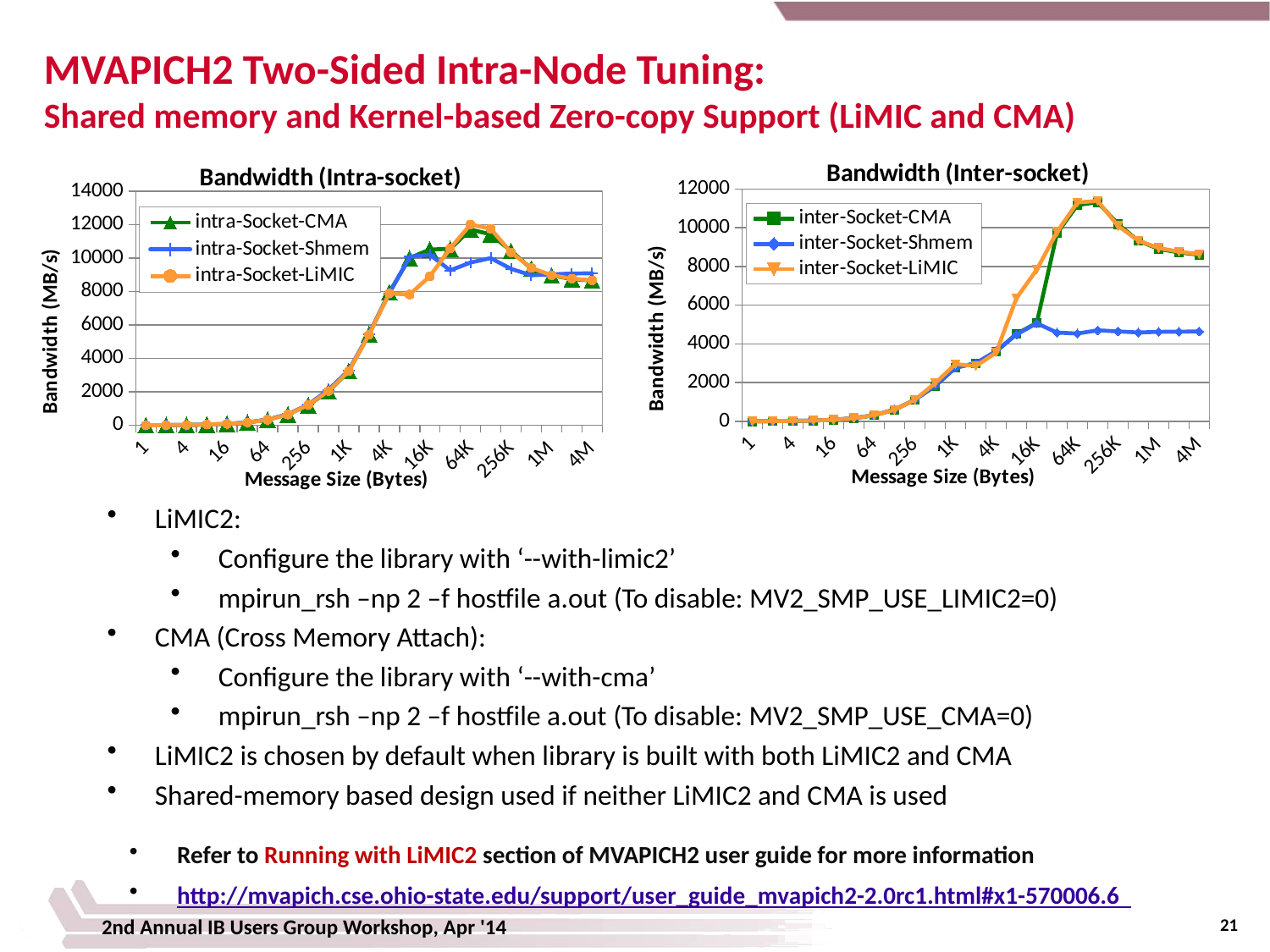
In the Bandwidth (Inter-socket) chart, which is larger at 4M: inter-Socket-CMA or inter-Socket-Shmem? inter-Socket-CMA In the Bandwidth (Inter-socket) chart, which series has the lowest value at 4M? inter-Socket-Shmem In the Bandwidth (Intra-socket) chart, which is larger at 64K: intra-Socket-LiMIC or intra-Socket-Shmem? intra-Socket-LiMIC In the Bandwidth (Inter-socket) chart, does the inter-Socket-LiMIC series rise or fall between 256 and 64K? rise In the Bandwidth (Intra-socket) chart, is the value for intra-Socket-LiMIC at 64K greater or less than 10000? greater What kind of chart is the Bandwidth (Intra-socket) chart? line chart In the Bandwidth (Inter-socket) chart, is the value for inter-Socket-Shmem at 4M greater or less than 6000? less In the Bandwidth (Inter-socket) chart, is the value for inter-Socket-LiMIC at 64K greater or less than 10000? greater How many series does the legend of the Bandwidth (Inter-socket) chart list? 3 What is the y-axis title of the Bandwidth (Inter-socket) chart? Bandwidth (MB/s) In the Bandwidth (Intra-socket) chart, what are the three series named in the legend? intra-Socket-CMA, intra-Socket-Shmem, intra-Socket-LiMIC